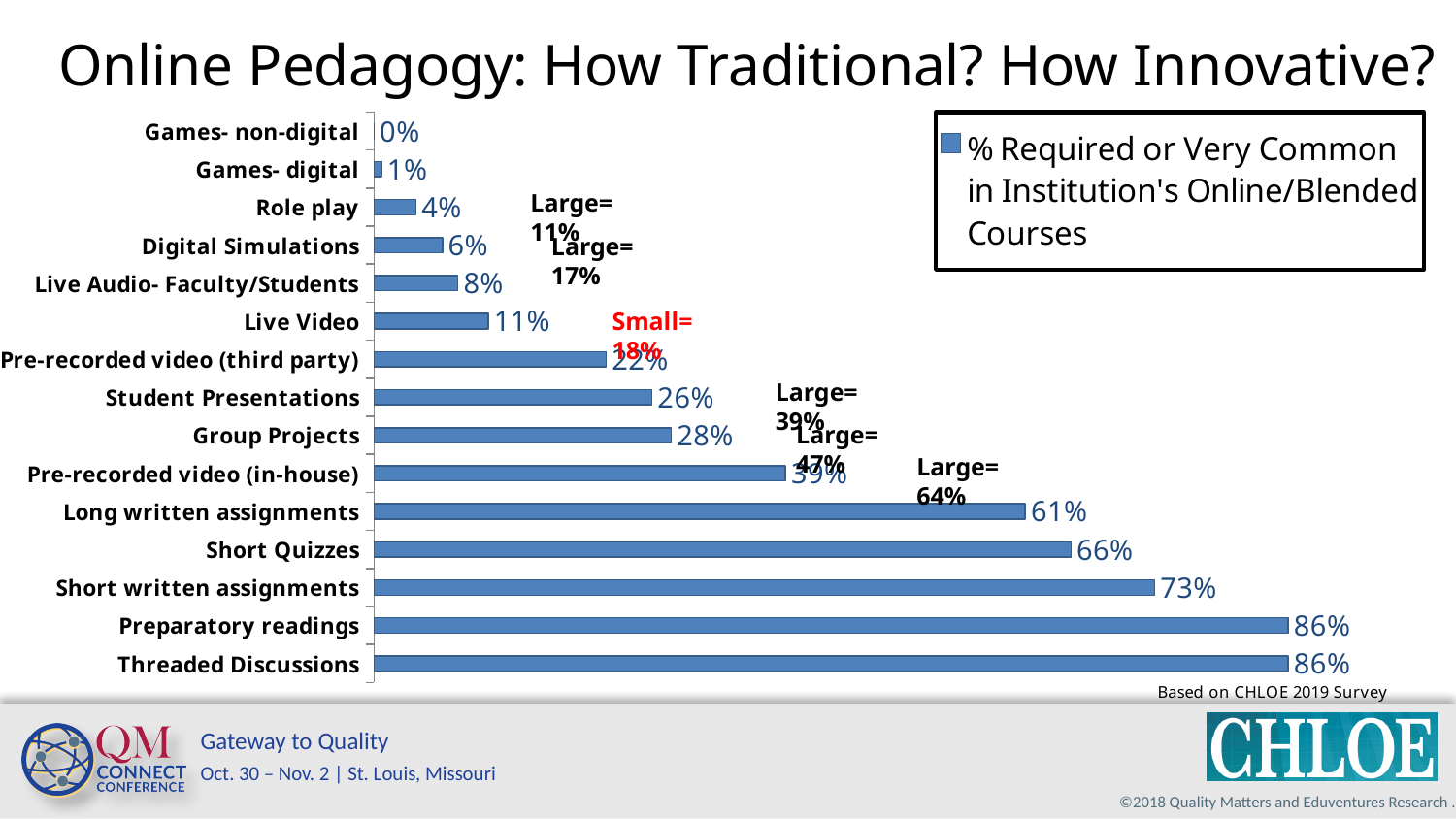
What is the difference between Preparatory readings and Student Presentations? 60% What is the difference between Short written assignments and Long written assignments? 12% What is the legend entry for the series shown in the chart? % Required or Very Common in Institution's Online/Blended Courses How many series does the legend list? 1 What is the value for Live Video? 11% What is the value for Pre-recorded video (in-house)? 39% What is the value for Short Quizzes? 66% Which is larger, Digital Simulations or Live Audio- Faculty/Students? Live Audio- Faculty/Students How many categories are shown in the chart? 15 What is the value for Group Projects? 28% Which category has the lowest value? Games- non-digital What kind of chart is shown on the slide? Bar chart